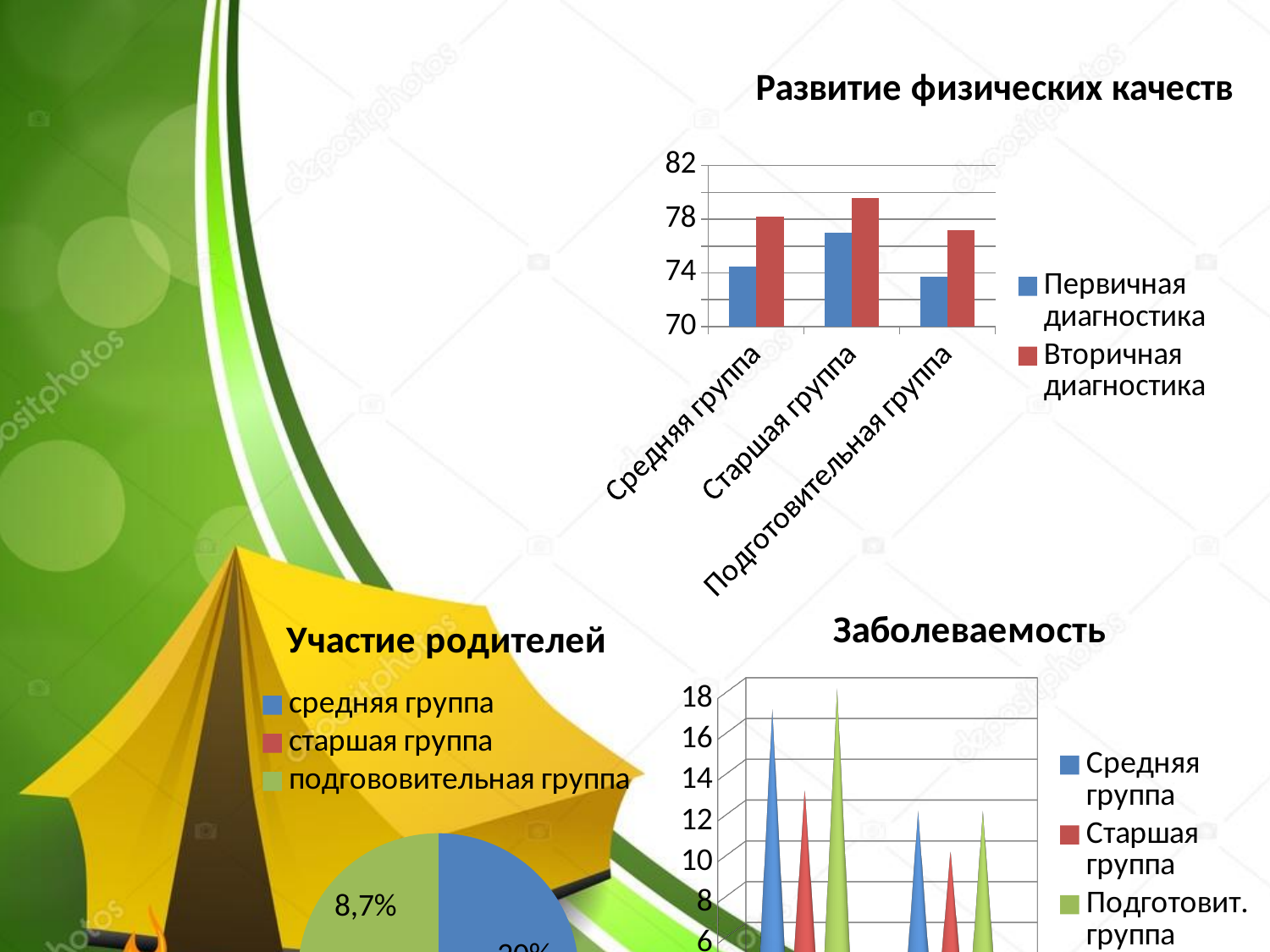
How many series does the legend of "Заболеваемость" list? 3 In "Развитие физических качеств", for Средняя группа, which is larger: Первичная диагностика or Вторичная диагностика? Вторичная диагностика In "Развитие физических качеств", is the Первичная диагностика value for Подготовительная группа greater or less than 78? less In "Развитие физических качеств", which group has the lowest value for Вторичная диагностика? Подготовительная группа In "Развитие физических качеств", is the Вторичная диагностика value for Подготовительная группа greater or less than 78? less What kind of chart is "Развитие физических качеств"? bar chart In "Развитие физических качеств", is the Вторичная диагностика value for Старшая группа greater or less than 78? greater How many entries does the legend of "Участие родителей" list? 3 How many series does the legend of "Развитие физических качеств" list? 2 What kind of chart is "Участие родителей"? pie chart In "Развитие физических качеств", which group has the highest value for Первичная диагностика? Старшая группа How many groups (categories) are shown on the x axis of "Развитие физических качеств"? 3